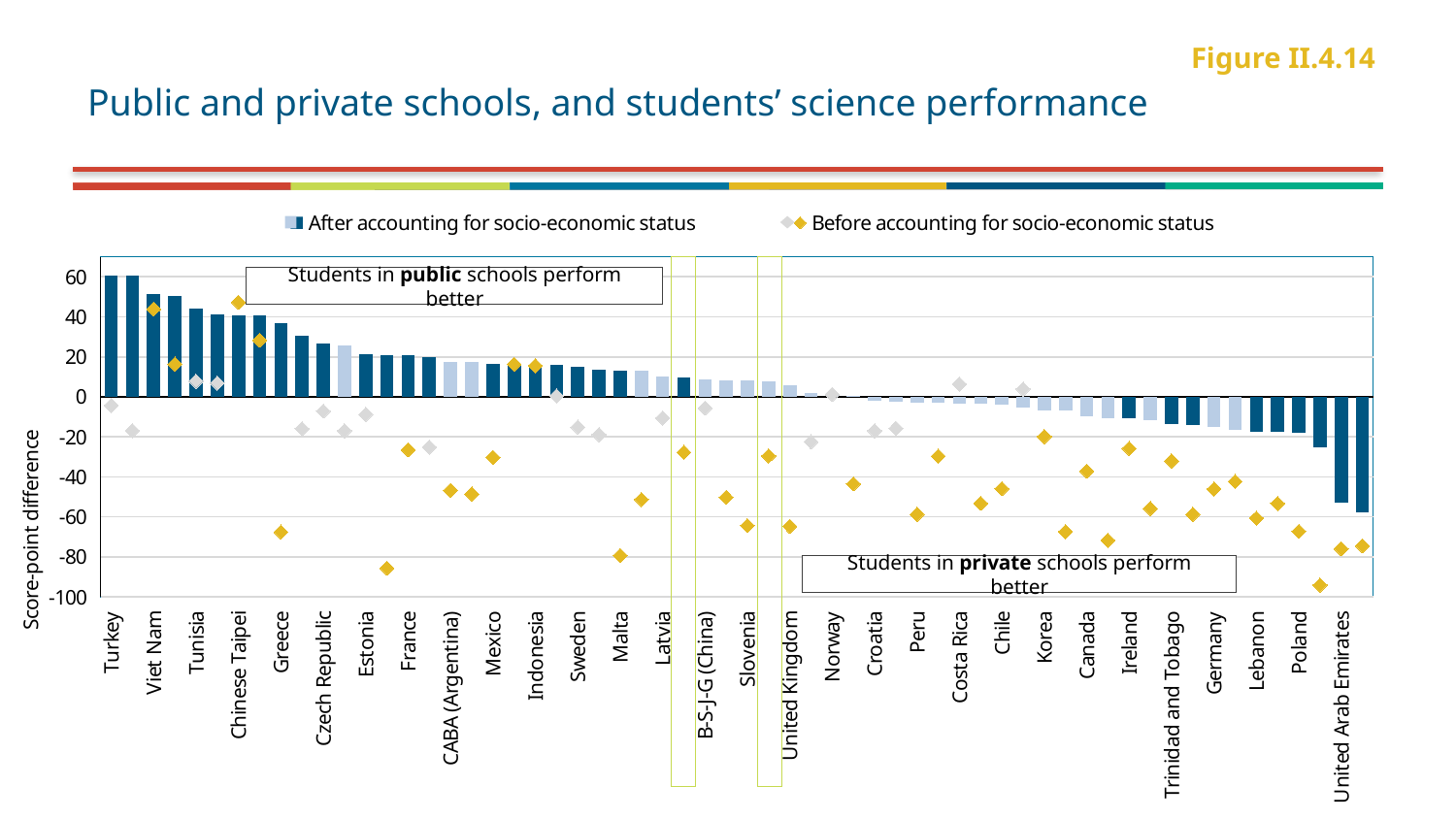
How many series does the legend list? 2 Is the bar for Turkey (after accounting for socio-economic status) greater or less than 40? greater Is the bar for United Arab Emirates (after accounting for socio-economic status) greater or less than -40? less Is the bar for Czech Republic (after accounting for socio-economic status) greater or less than 20? greater Which has the larger bar after accounting for socio-economic status, Turkey or Viet Nam? Turkey What is the title of the chart? Public and private schools, and students' science performance Do the bars for 'After accounting for socio-economic status' rise or fall from left to right across the countries? fall What kind of chart is shown on the slide? combination bar and line chart What is the label of the vertical axis? Score-point difference